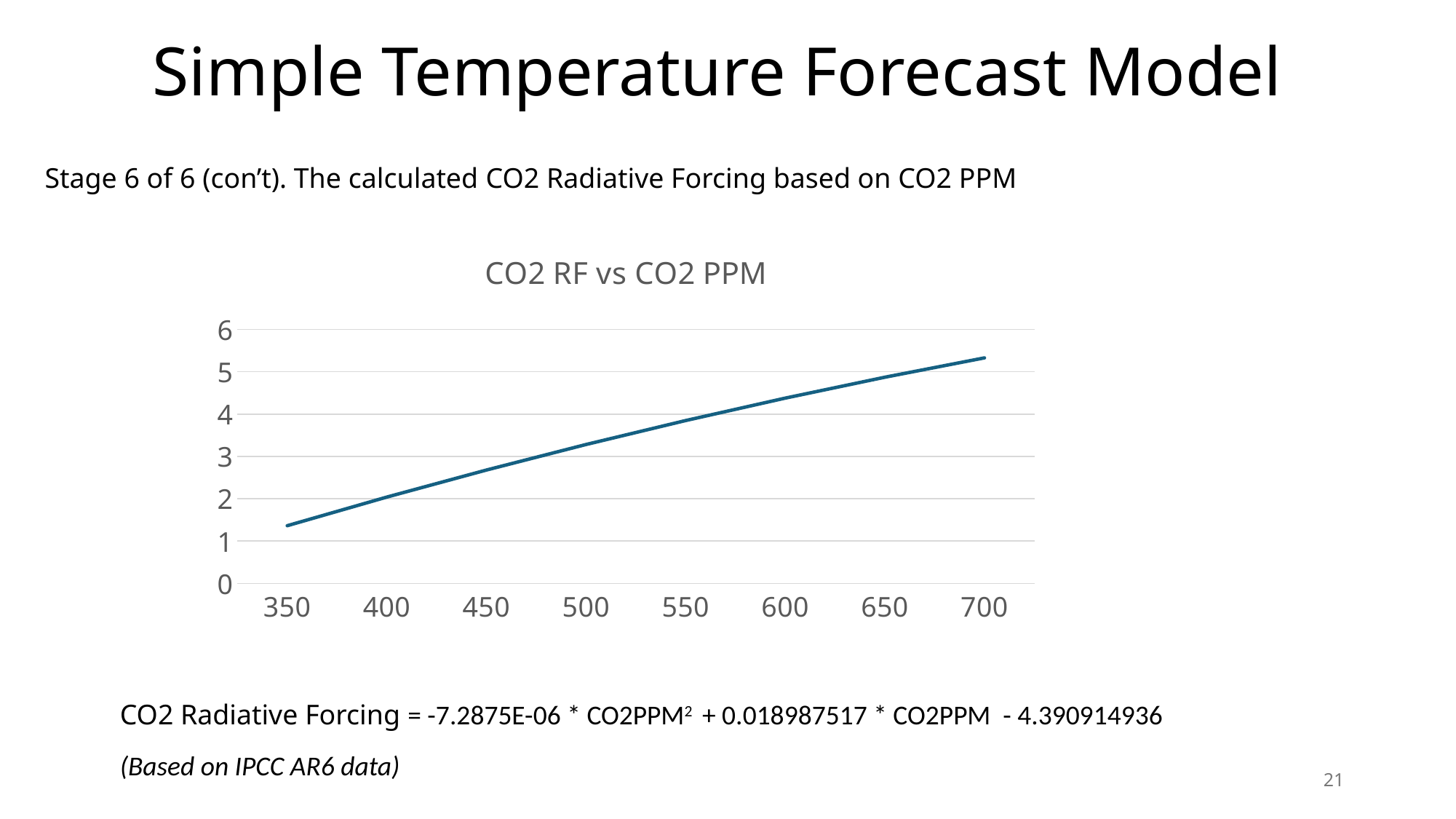
Does the CO2 RF value rise or fall as CO2 PPM increases along the x axis? rise Which has the larger CO2 RF value, 400 PPM or 650 PPM? 650 PPM What is the title of the chart? CO2 RF vs CO2 PPM Is the CO2 RF value at 350 PPM greater or less than 2? less How many tick labels are shown on the x axis? 8 What kind of chart is shown on the slide? line chart At which CO2 PPM value shown on the x axis is CO2 RF lowest? 350 Is the CO2 RF value at 450 PPM greater or less than 3? less Is the CO2 RF value at 700 PPM greater or less than 5? greater At which CO2 PPM value shown on the x axis is CO2 RF highest? 700